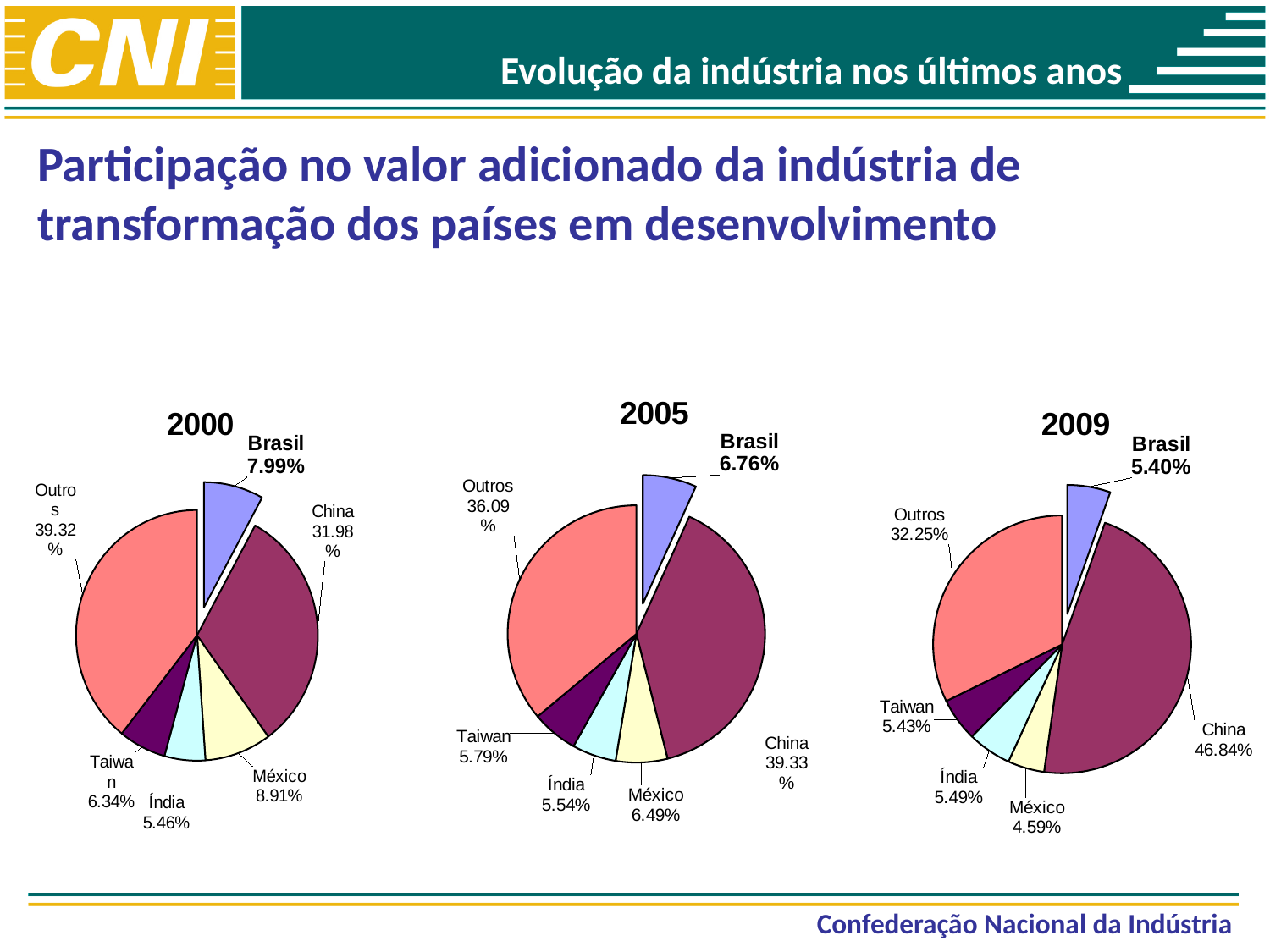
In the 2005 pie chart, which is larger, the share for Taiwan or the share for Índia? Taiwan In the 2009 pie chart, which category has the largest share? China In the 2000 pie chart, which is larger, the share for México or the share for Brasil? México In the 2000 pie chart, which category has the smallest share? Índia How many slices does the 2009 pie chart have? 6 In the 2005 pie chart, what is the share for China? 39.33% In the 2000 pie chart, what is the share for Brasil? 7.99% In the 2009 pie chart, which category has the smallest share? México In the 2005 pie chart, what is the difference between the shares of China and Outros? 3.24% What kind of chart is used to show the 2000 data? Pie chart In the 2009 pie chart, what is the share for México? 4.59% How many pie charts are shown on the slide? 3